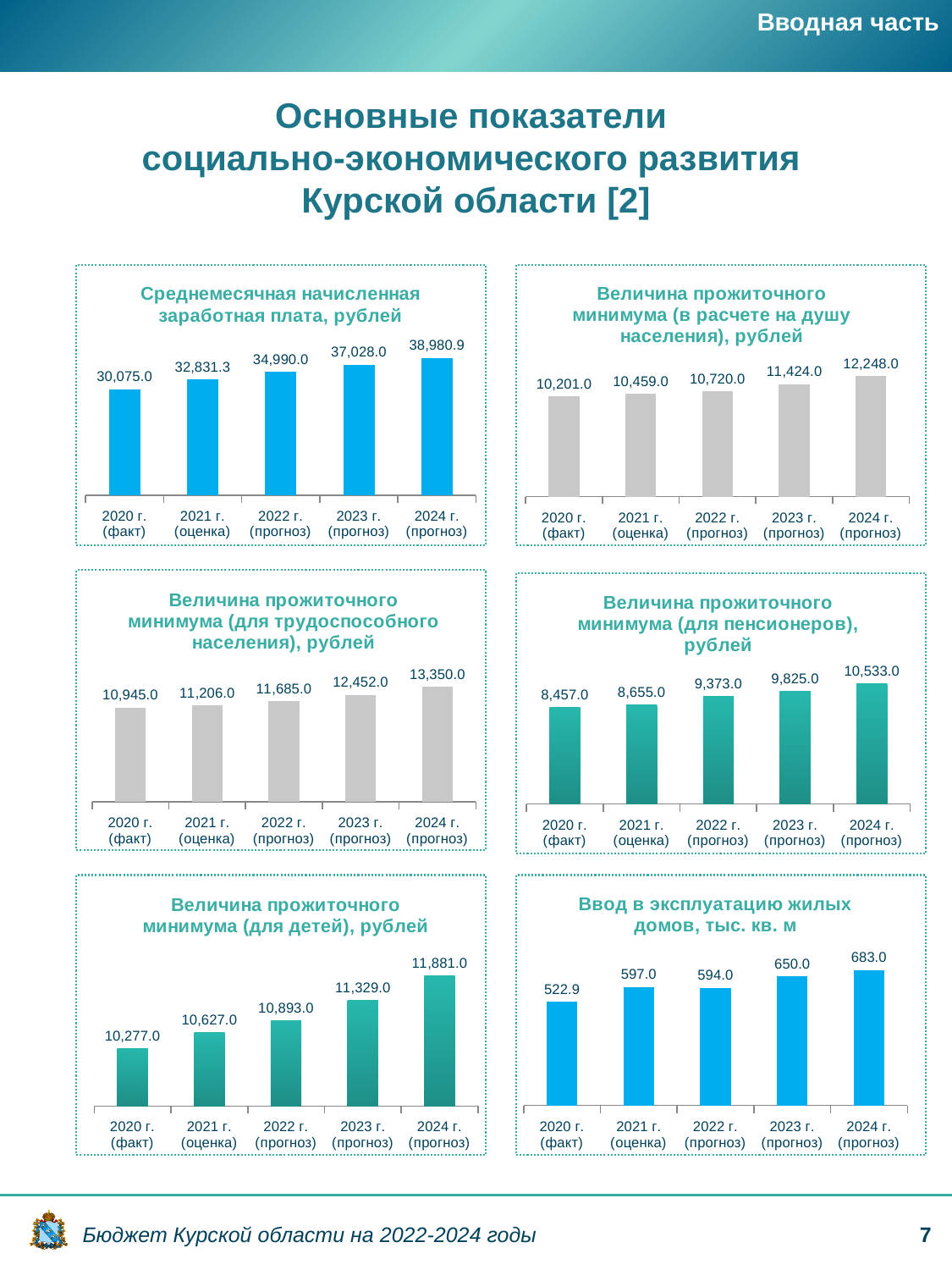
In the chart 'Величина прожиточного минимума (для пенсионеров), рублей', what is the value for 2020 г. (факт)? 8,457.0 In the chart 'Величина прожиточного минимума (в расчете на душу населения), рублей', what is the value for 2023 г. (прогноз)? 11,424.0 What type of chart is 'Среднемесячная начисленная заработная плата, рублей'? Bar chart In the chart 'Ввод в эксплуатацию жилых домов, тыс. кв. м', what is the value for 2020 г. (факт)? 522.9 In the chart 'Среднемесячная начисленная заработная плата, рублей', what is the difference between the 2024 г. (прогноз) and 2020 г. (факт) values? 8,905.9 In the chart 'Среднемесячная начисленная заработная плата, рублей', what is the value for 2022 г. (прогноз)? 34,990.0 In the chart 'Ввод в эксплуатацию жилых домов, тыс. кв. м', which is larger: the value for 2021 г. (оценка) or 2022 г. (прогноз)? 2021 г. (оценка) In the chart 'Величина прожиточного минимума (в расчете на душу населения), рублей', which year has the lowest value? 2020 г. (факт) In the chart 'Величина прожиточного минимума (для детей), рублей', which year has the highest value? 2024 г. (прогноз) In the chart 'Величина прожиточного минимума (для трудоспособного населения), рублей', how many bars are plotted? 5 In the chart 'Величина прожиточного минимума (для трудоспособного населения), рублей', what is the value for 2024 г. (прогноз)? 13,350.0 In the chart 'Величина прожиточного минимума (для пенсионеров), рублей', what is the difference between the 2024 г. (прогноз) and 2020 г. (факт) values? 2,076.0